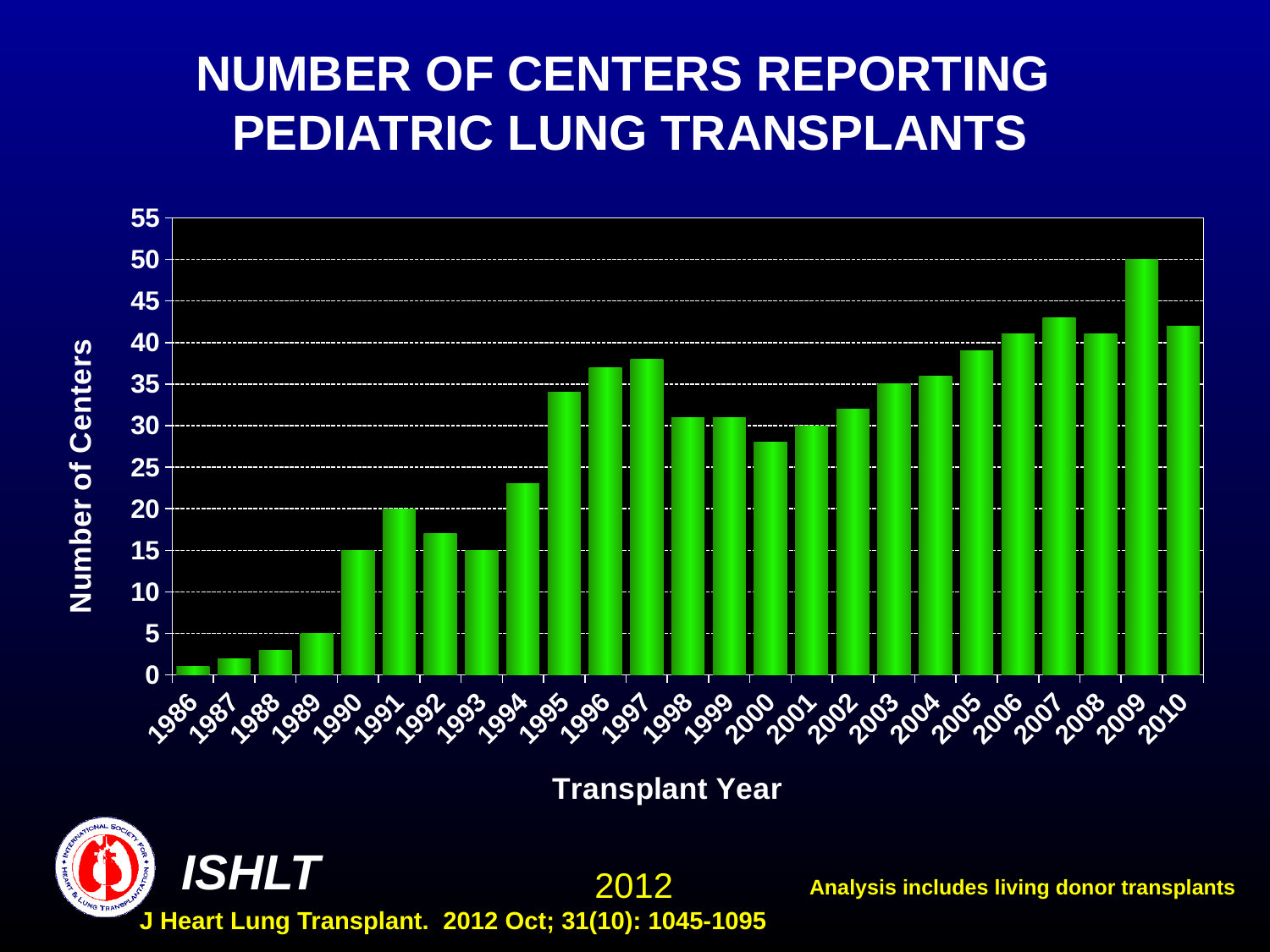
What is the number of centers reporting in 1991? 20 Which transplant year has the lowest number of centers reporting? 1986 How many transplant years are shown on the x axis? 25 What is the number of centers reporting in 2009? 50 Is the number of centers reporting in 2000 greater or less than 30? less Which transplant year has the highest number of centers reporting? 2009 What is the number of centers reporting in 1989? 5 What kind of chart is shown on the slide? bar chart Is the number of centers reporting in 2007 greater or less than 40? greater Overall, do the number of centers reporting rise or fall from 1986 to 2010? rise What is the label of the y axis? Number of Centers Which year has more centers reporting, 1997 or 1998? 1997